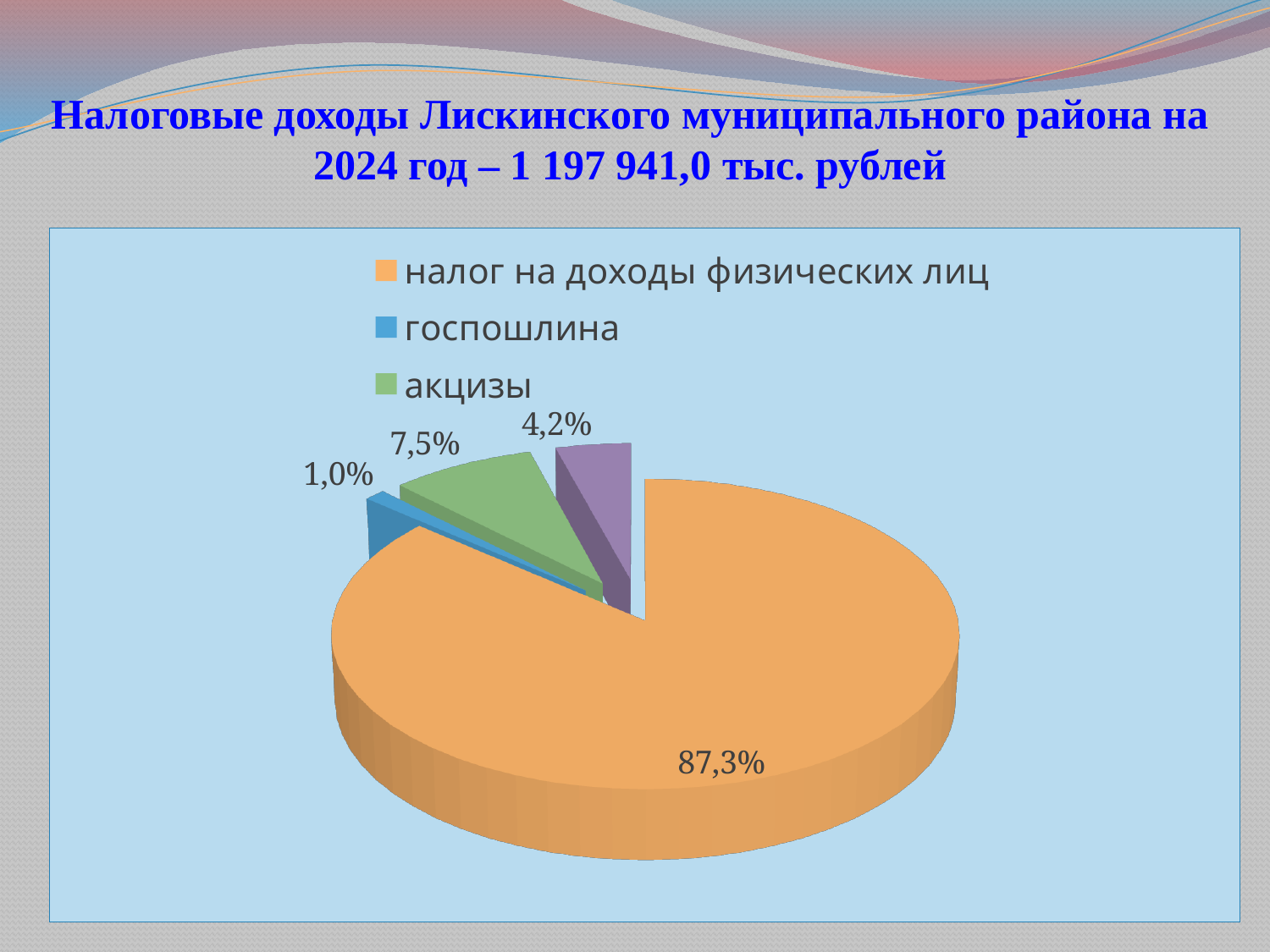
By how many percentage points does the налог на доходы физических лиц slice exceed the акцизы slice? 79,8% Which is larger, the slice for акцизы or the slice for госпошлина? акцизы How many entries does the legend list? 3 What kind of chart is shown on the slide? pie chart By how many percentage points does the акцизы slice exceed the госпошлина slice? 6,5% What share of the pie is labelled for налог на доходы физических лиц? 87,3% What share of the pie is labelled for госпошлина? 1,0% How many slices does the pie chart have? 4 What share of the pie is labelled for акцизы? 7,5% Which category has the largest slice of the pie? налог на доходы физических лиц What total amount of tax revenue for 2024 is stated in the slide title? 1 197 941,0 тыс. рублей Which category has the smallest slice of the pie? госпошлина